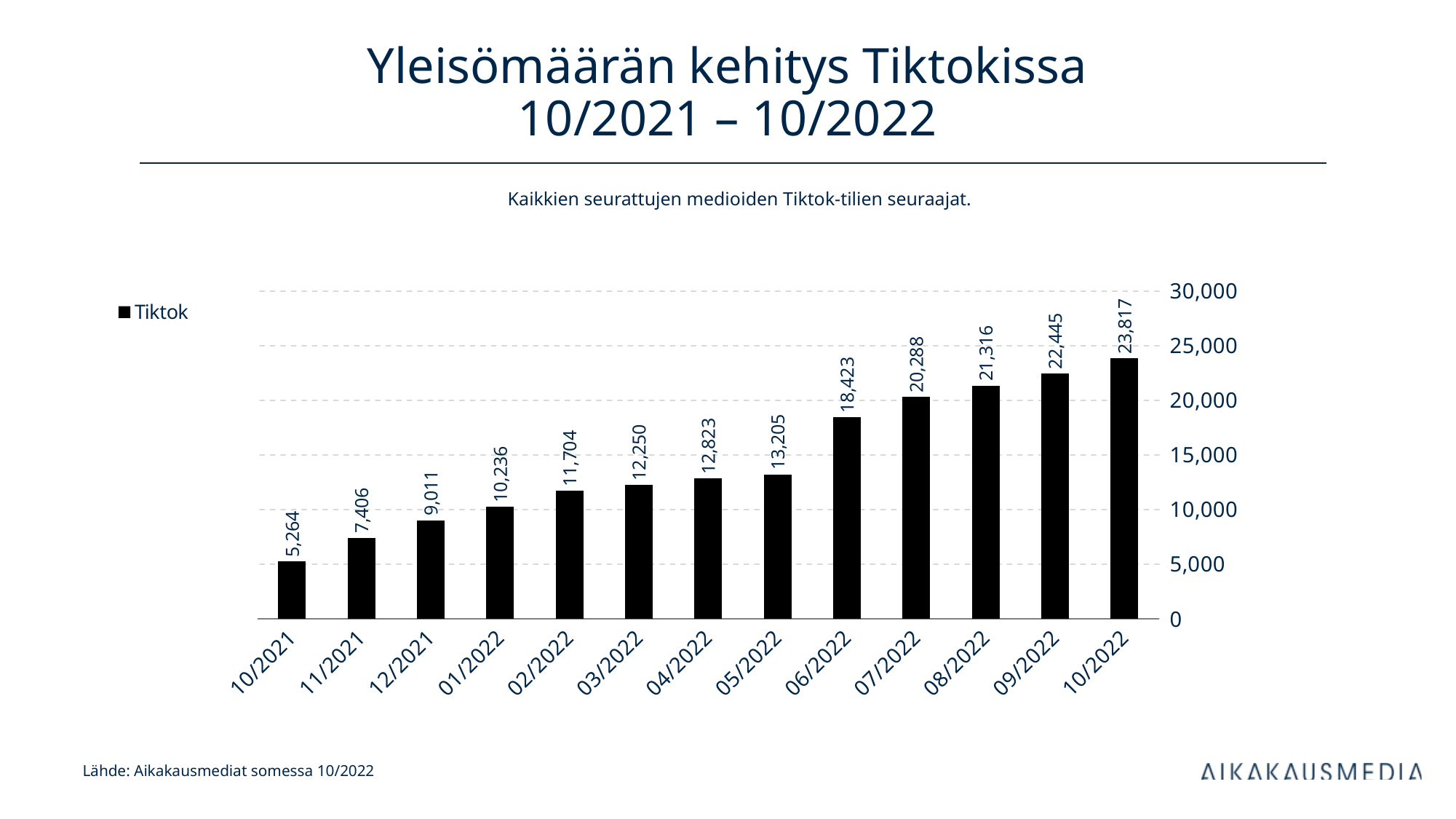
What kind of chart is shown on the slide? bar chart Which is larger, the value for 03/2022 or the value for 08/2022? 08/2022 Which month has the highest value? 10/2022 What is the difference between the values for 06/2022 and 05/2022? 5,218 Is the value for 07/2022 greater or less than 20,000? greater What is the difference between the values for 10/2022 and 10/2021? 18,553 Which month has the lowest value? 10/2021 What is the value for 10/2022? 23,817 What is the value for 06/2022? 18,423 What is the value for 10/2021? 5,264 How many months are shown on the x axis? 13 Do the values rise or fall from 10/2021 to 10/2022? rise